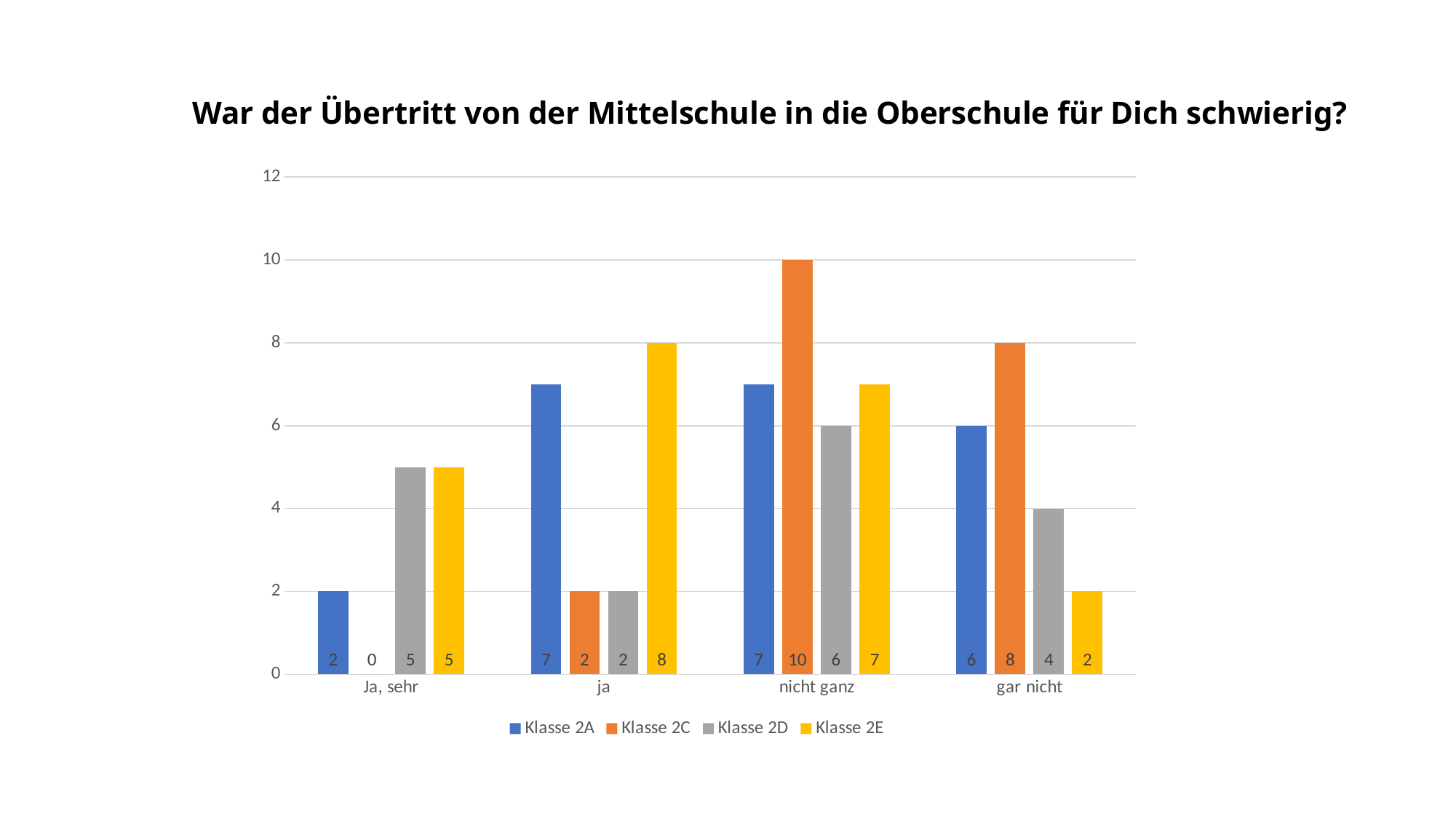
What is the value for Klasse 2C in the 'nicht ganz' category? 10 How many response categories are shown on the x axis? 4 What is the total of all four classes in the 'ja' category? 19 How many series does the legend list? 4 Which class has the lowest value in the 'Ja, sehr' category? Klasse 2C Which is larger in the 'gar nicht' category: Klasse 2A or Klasse 2D? Klasse 2A What is the value for Klasse 2E in the 'ja' category? 8 What is the difference between Klasse 2C and Klasse 2D in the 'nicht ganz' category? 4 What kind of chart is shown on the slide? Bar chart Which class has the highest value in the 'gar nicht' category? Klasse 2C What colour represents Klasse 2E in the chart? Yellow What is the value for Klasse 2A in the 'Ja, sehr' category? 2